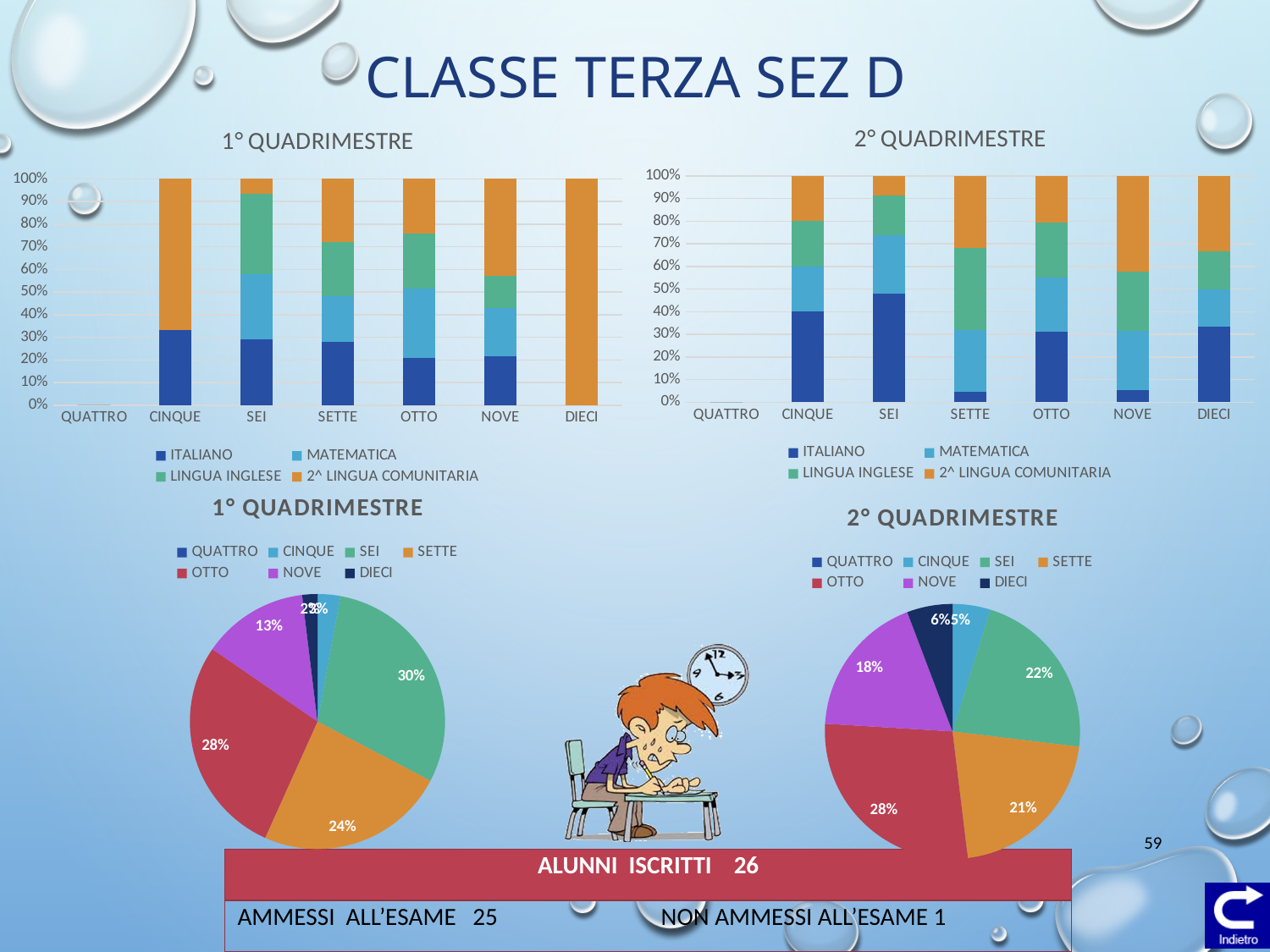
What kind of chart is the 1° QUADRIMESTRE chart at the top left of the slide? Stacked bar chart How many categories are shown on the x axis of the 1° QUADRIMESTRE stacked bar chart? 7 In the 1° QUADRIMESTRE pie chart, what share does NOVE have? 13% In the 1° QUADRIMESTRE pie chart, which is larger, the share of OTTO or the share of SETTE? OTTO In the 2° QUADRIMESTRE pie chart, what share does SEI have? 22% In the 1° QUADRIMESTRE pie chart, which category has the largest share? SEI In the 2° QUADRIMESTRE pie chart, what share does OTTO have? 28% In the 2° QUADRIMESTRE stacked bar chart, is the ITALIANO value for SETTE greater or less than 10%? less How many series does the legend of the 2° QUADRIMESTRE stacked bar chart list? 4 In the 2° QUADRIMESTRE stacked bar chart, is the ITALIANO value for SEI greater or less than 40%? greater In the 2° QUADRIMESTRE pie chart, what is the difference between the shares of OTTO and NOVE? 10%